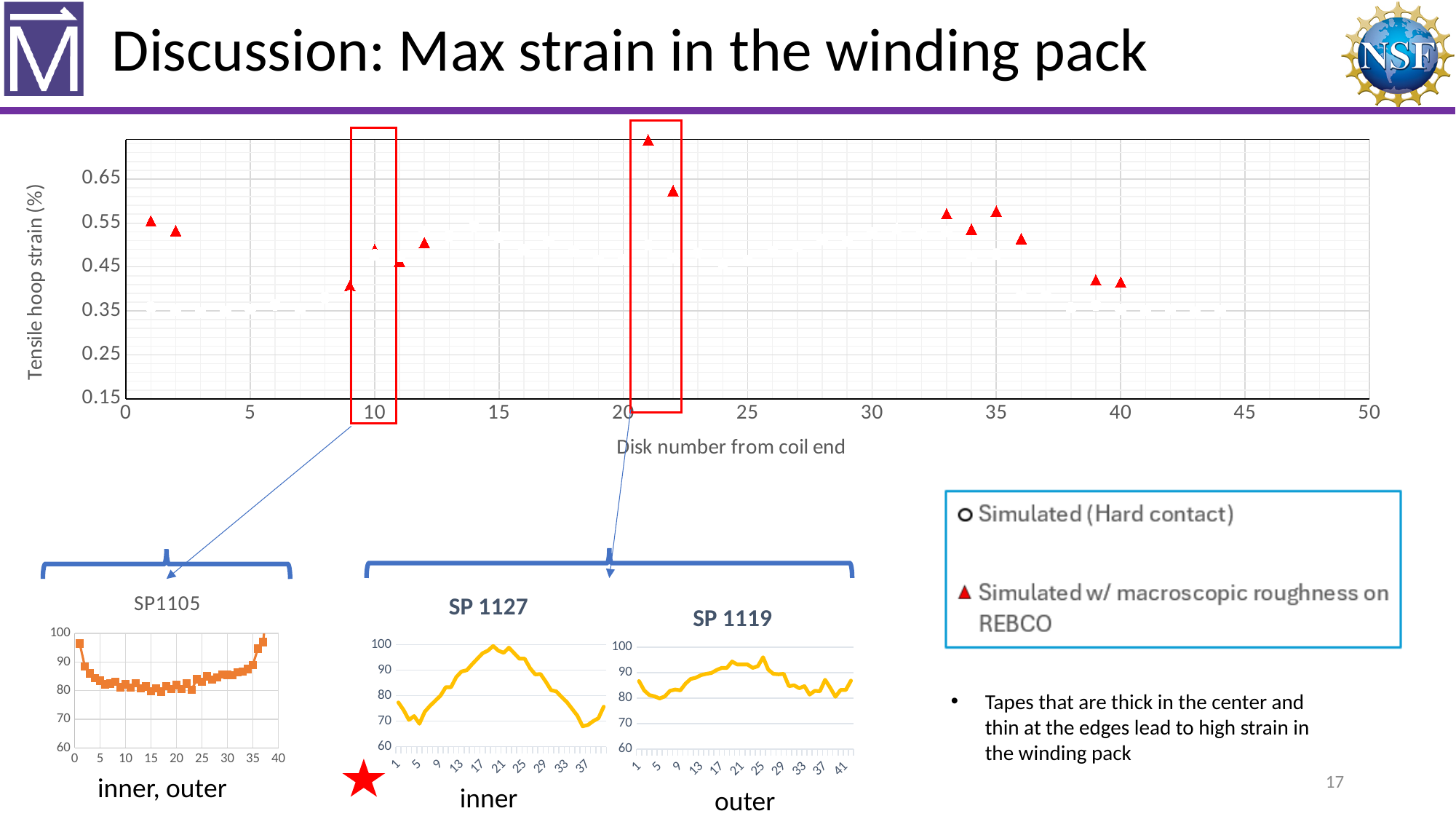
In the SP 1127 chart, is the value at x = 21 greater or less than 90? greater How many series does the legend box on the right list? 2 In the top chart, is the tensile hoop strain at disk number 1 greater or less than 0.45? greater In the top chart, at which disk number is the tensile hoop strain highest? 21 What is the x-axis title of the top chart? Disk number from coil end How many data points are plotted in the top chart? 14 In the top chart, which has the higher tensile hoop strain: disk number 35 or disk number 40? disk number 35 In the SP1105 chart, do the values fall or rise from x = 1 to x = 15? fall In the top chart, is the tensile hoop strain at disk number 40 greater or less than 0.45? less What kind of chart is the large chart at the top of the slide? scatter chart In the top chart, which has the higher tensile hoop strain: disk number 21 or disk number 1? disk number 21